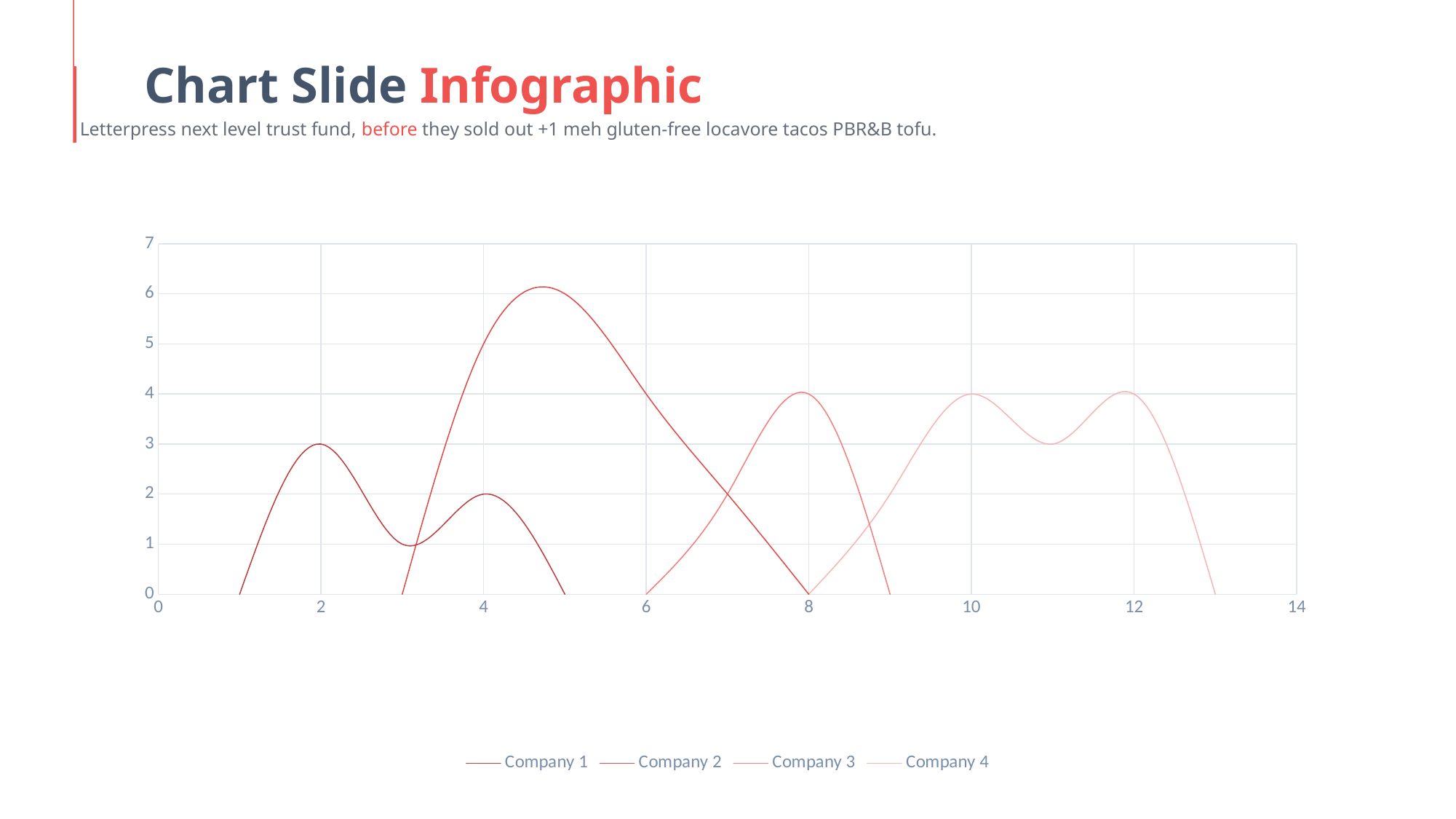
What kind of chart is shown on the slide? line chart Is the highest value reached by Company 1 greater or less than 4? less Is the peak value of Company 3 greater or less than 5? less Which series has the lowest peak value on the chart? Company 1 Is the peak value of Company 2 greater or less than 5? greater How many series does the legend list? 4 Which series reaches the highest value on the chart? Company 2 What is the maximum value shown on the vertical axis? 7 What is the maximum value shown on the horizontal axis? 14 Which series reaches a higher peak, Company 2 or Company 3? Company 2